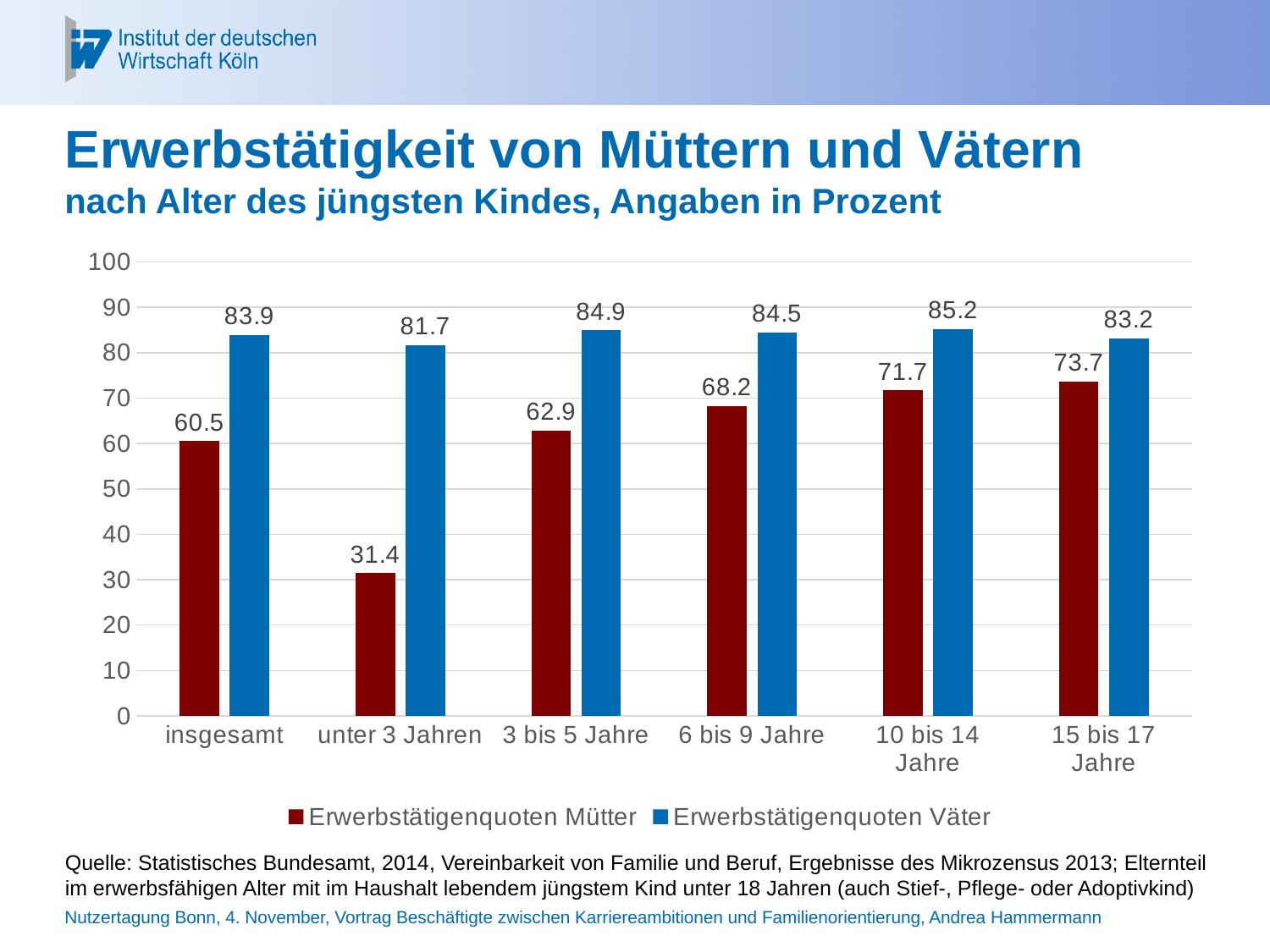
Which category has the highest Erwerbstätigenquoten Väter value? 10 bis 14 Jahre How many series does the legend list? 2 What is the difference between the Väter and Mütter values for 'unter 3 Jahren'? 50.3 Which category has the lowest Erwerbstätigenquoten Mütter value? unter 3 Jahren How many categories are shown on the x axis? 6 Do the Erwerbstätigenquoten Mütter values rise or fall from 'unter 3 Jahren' to '15 bis 17 Jahre'? rise What is the Erwerbstätigenquoten Mütter value for 'insgesamt'? 60.5 What is the Erwerbstätigenquoten Väter value for '3 bis 5 Jahre'? 84.9 What is the Erwerbstätigenquoten Mütter value for 'unter 3 Jahren'? 31.4 Which is larger: the Mütter value for '15 bis 17 Jahre' or the Mütter value for '10 bis 14 Jahre'? 15 bis 17 Jahre Which colour represents Erwerbstätigenquoten Väter in the legend? blue What kind of chart is shown on the slide? bar chart